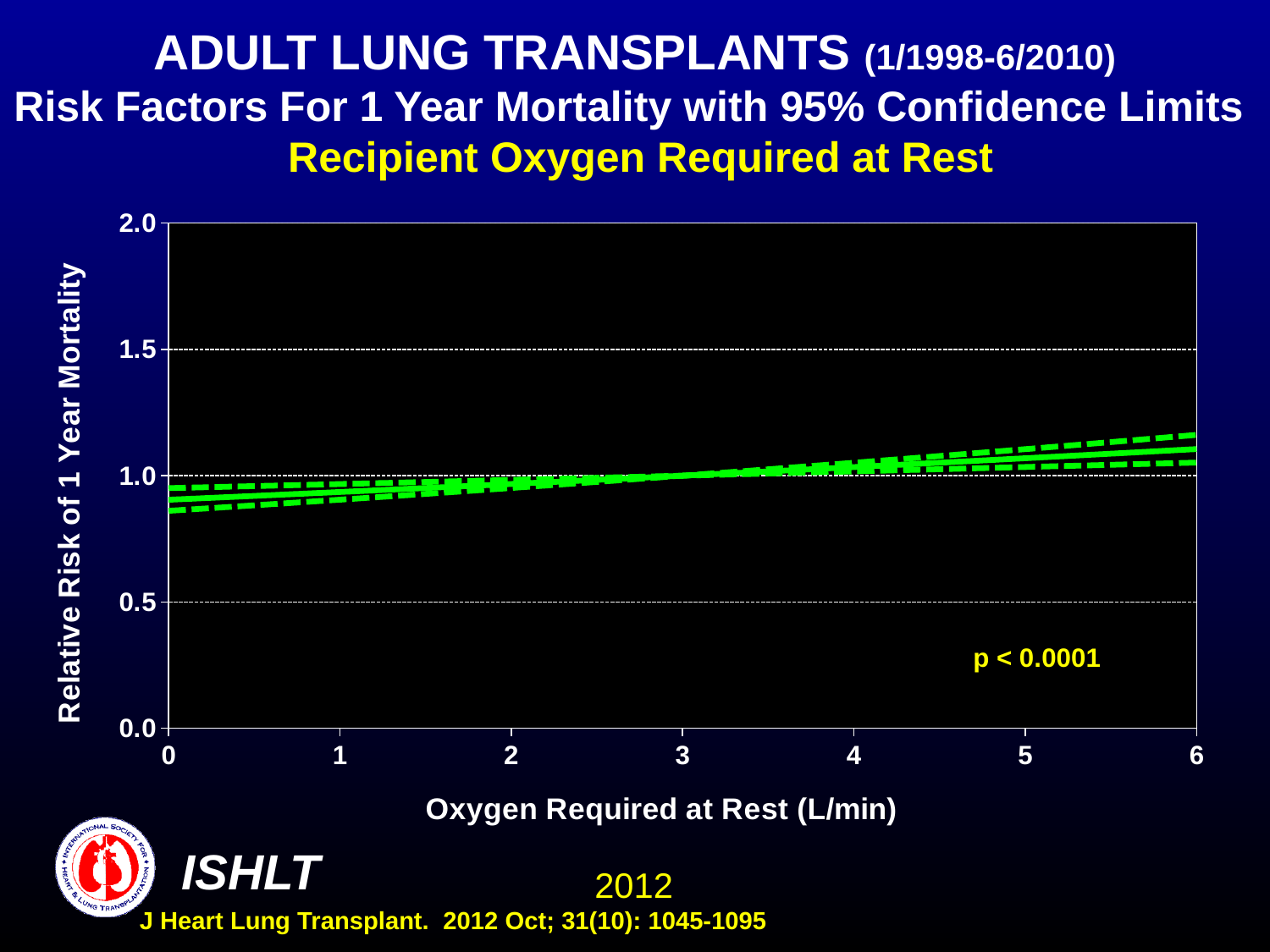
What is the label of the x axis of the chart? Oxygen Required at Rest (L/min) Is the relative risk of 1 year mortality at 6 L/min oxygen required at rest greater or less than 1.5? less What p-value is shown on the chart? p < 0.0001 What is the highest value shown on the y axis of the chart? 2.0 What kind of chart is shown on the slide? line chart Is the relative risk of 1 year mortality at 0 L/min oxygen required at rest greater or less than 1.0? less Is the relative risk of 1 year mortality at 0 L/min oxygen required at rest greater or less than 0.5? greater Does the relative risk of 1 year mortality rise or fall as oxygen required at rest increases along the x axis? rise What is the highest value shown on the x axis of the chart? 6 Which is larger, the relative risk of 1 year mortality at 1 L/min or at 5 L/min oxygen required at rest? 5 L/min How many lines are plotted on the chart, including the confidence limit lines? 3